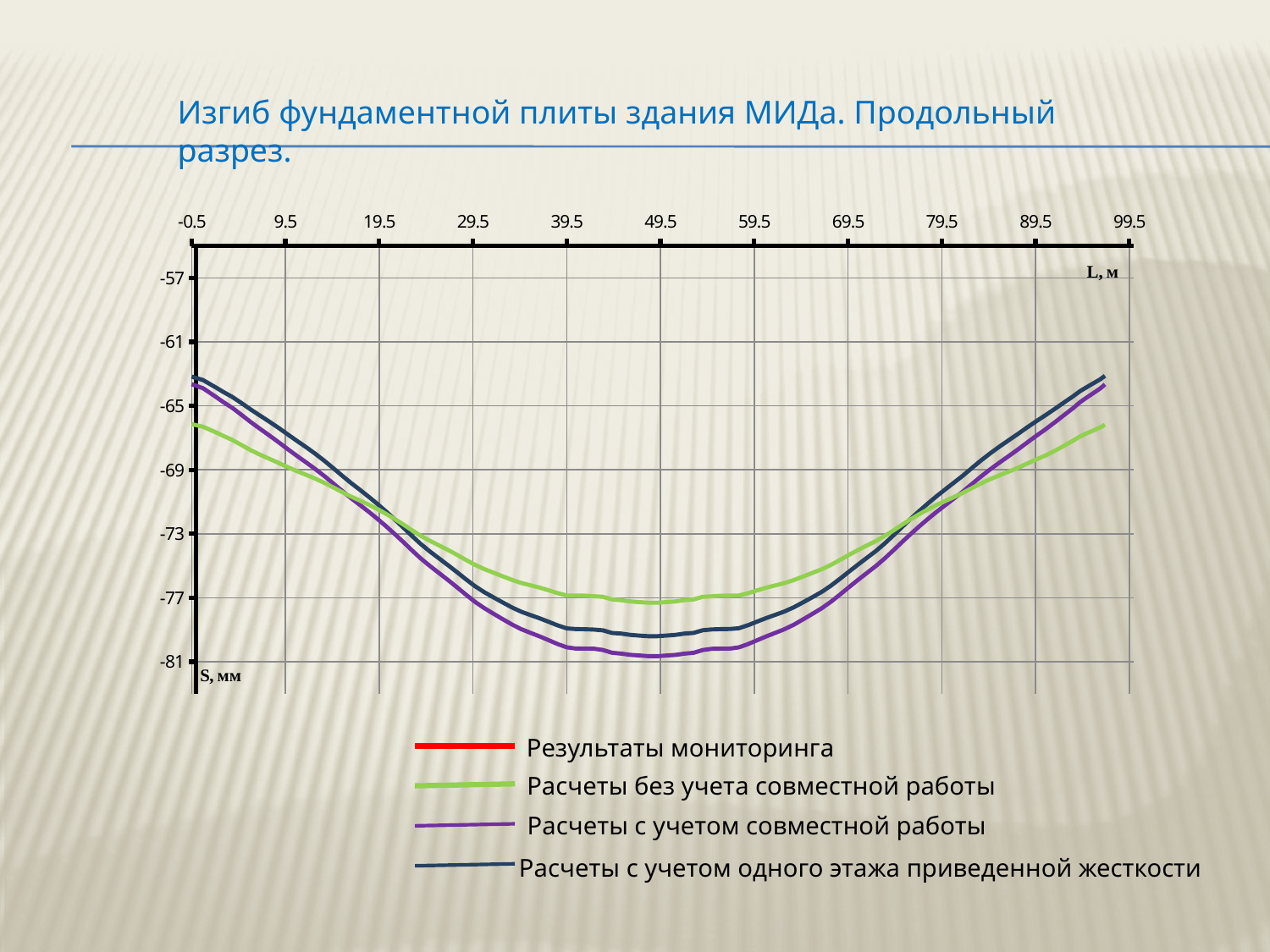
Is the value of the 'Расчеты без учета совместной работы' line at L = 49.5 greater or less than -81? greater Which series reaches the lowest value on the chart? Расчеты с учетом совместной работы At L = -0.5, which line is higher: 'Расчеты с учетом одного этажа приведенной жесткости' or 'Расчеты без учета совместной работы'? Расчеты с учетом одного этажа приведенной жесткости Is the value of the 'Расчеты с учетом совместной работы' line at L = 49.5 greater or less than -77? less Does the 'Расчеты с учетом совместной работы' line rise or fall as L goes from -0.5 to 49.5? fall Which legend entry is drawn in green? Расчеты без учета совместной работы At L = 49.5, which line is higher: 'Расчеты без учета совместной работы' or 'Расчеты с учетом совместной работы'? Расчеты без учета совместной работы How many series does the legend list? 4 What kind of chart is shown on the slide? line chart Is the value of the 'Расчеты с учетом одного этажа приведенной жесткости' line at L = 49.5 greater or less than -77? less What is the title of the slide's chart? Изгиб фундаментной плиты здания МИДа. Продольный разрез.